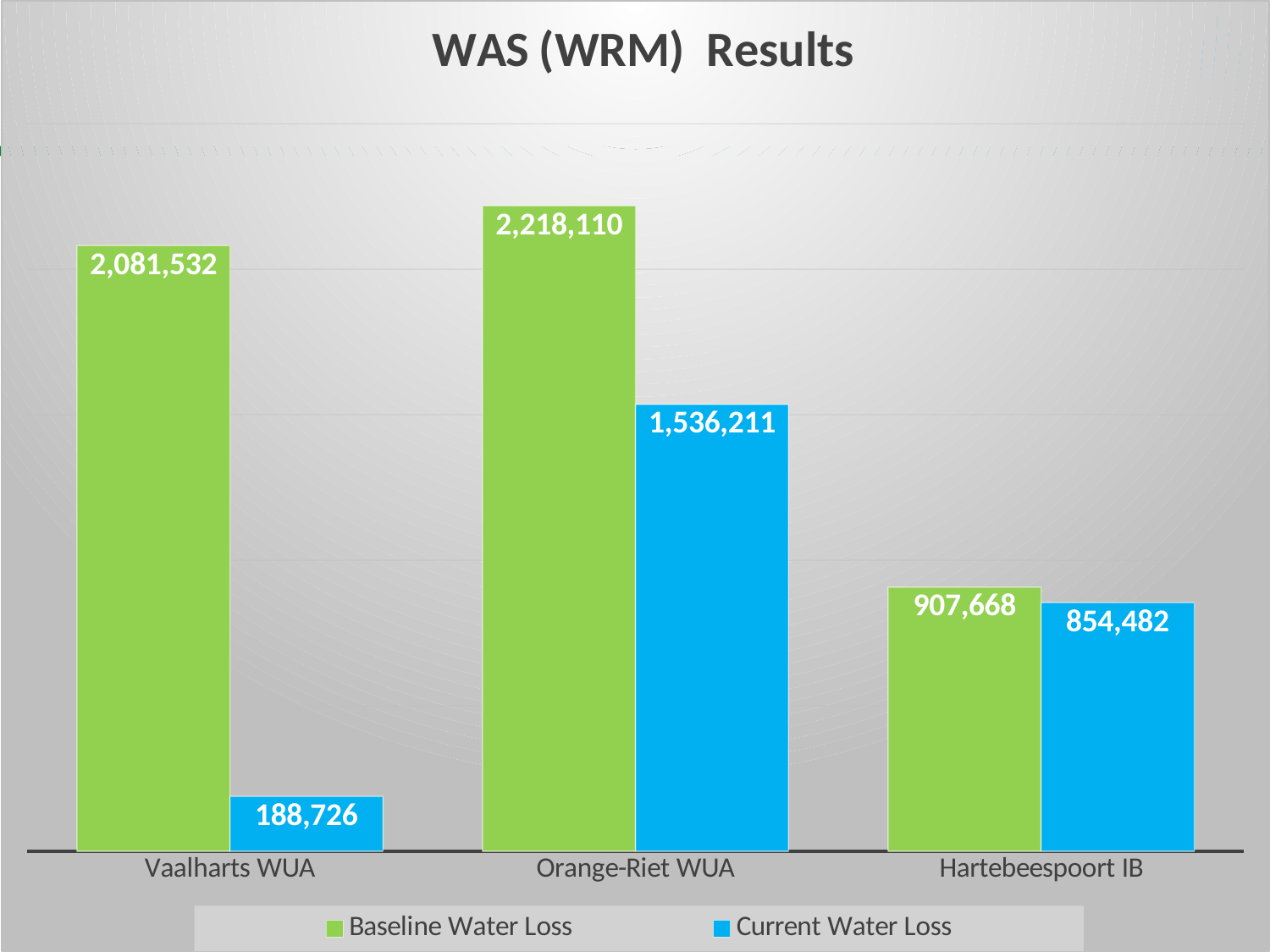
What is the difference between Baseline Water Loss and Current Water Loss for Vaalharts WUA? 1,892,806 Which is larger: the Current Water Loss for Orange-Riet WUA or the Baseline Water Loss for Hartebeespoort IB? Current Water Loss for Orange-Riet WUA How many categories are shown on the x axis? 3 What kind of chart is shown on the slide? Bar chart What is the title of the chart? WAS (WRM) Results What is the Current Water Loss value for Hartebeespoort IB? 854,482 Which category has the lowest Current Water Loss? Vaalharts WUA What is the Baseline Water Loss value for Vaalharts WUA? 2,081,532 Which category has the highest Baseline Water Loss? Orange-Riet WUA How many series does the legend list? 2 What is the difference between Baseline Water Loss and Current Water Loss for Orange-Riet WUA? 681,899 What is the Current Water Loss value for Orange-Riet WUA? 1,536,211